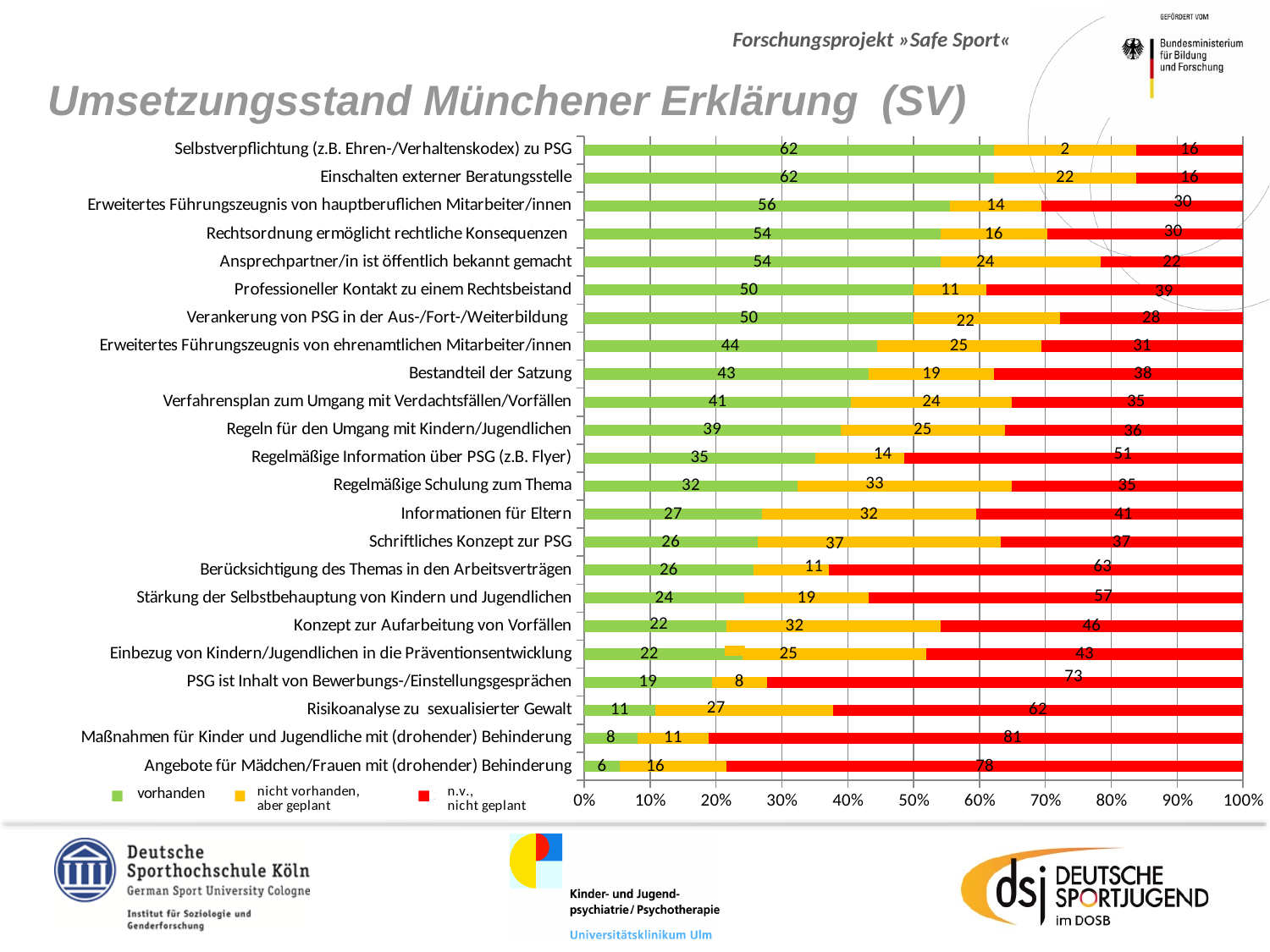
What is the 'vorhanden' value for 'Erweitertes Führungszeugnis von hauptberuflichen Mitarbeiter/innen'? 56 How many categories are plotted on the chart? 23 How many series does the legend list? 3 What is the 'nicht vorhanden, aber geplant' value for 'Schriftliches Konzept zur PSG'? 37 What kind of chart is shown on the slide? stacked bar chart Which category has the highest 'n.v., nicht geplant' value? Maßnahmen für Kinder und Jugendliche mit (drohender) Behinderung Which category has the lowest 'vorhanden' value? Angebote für Mädchen/Frauen mit (drohender) Behinderung What is the difference between the 'vorhanden' values for 'Rechtsordnung ermöglicht rechtliche Konsequenzen' and 'Regelmäßige Schulung zum Thema'? 22 What is the 'n.v., nicht geplant' value for 'PSG ist Inhalt von Bewerbungs-/Einstellungsgesprächen'? 73 Which is larger: the 'n.v., nicht geplant' value for 'Risikoanalyse zu sexualisierter Gewalt' or for 'Konzept zur Aufarbeitung von Vorfällen'? Risikoanalyse zu sexualisierter Gewalt What is the 'vorhanden' value for 'Bestandteil der Satzung'? 43 What is the title of the chart? Umsetzungsstand Münchener Erklärung (SV)